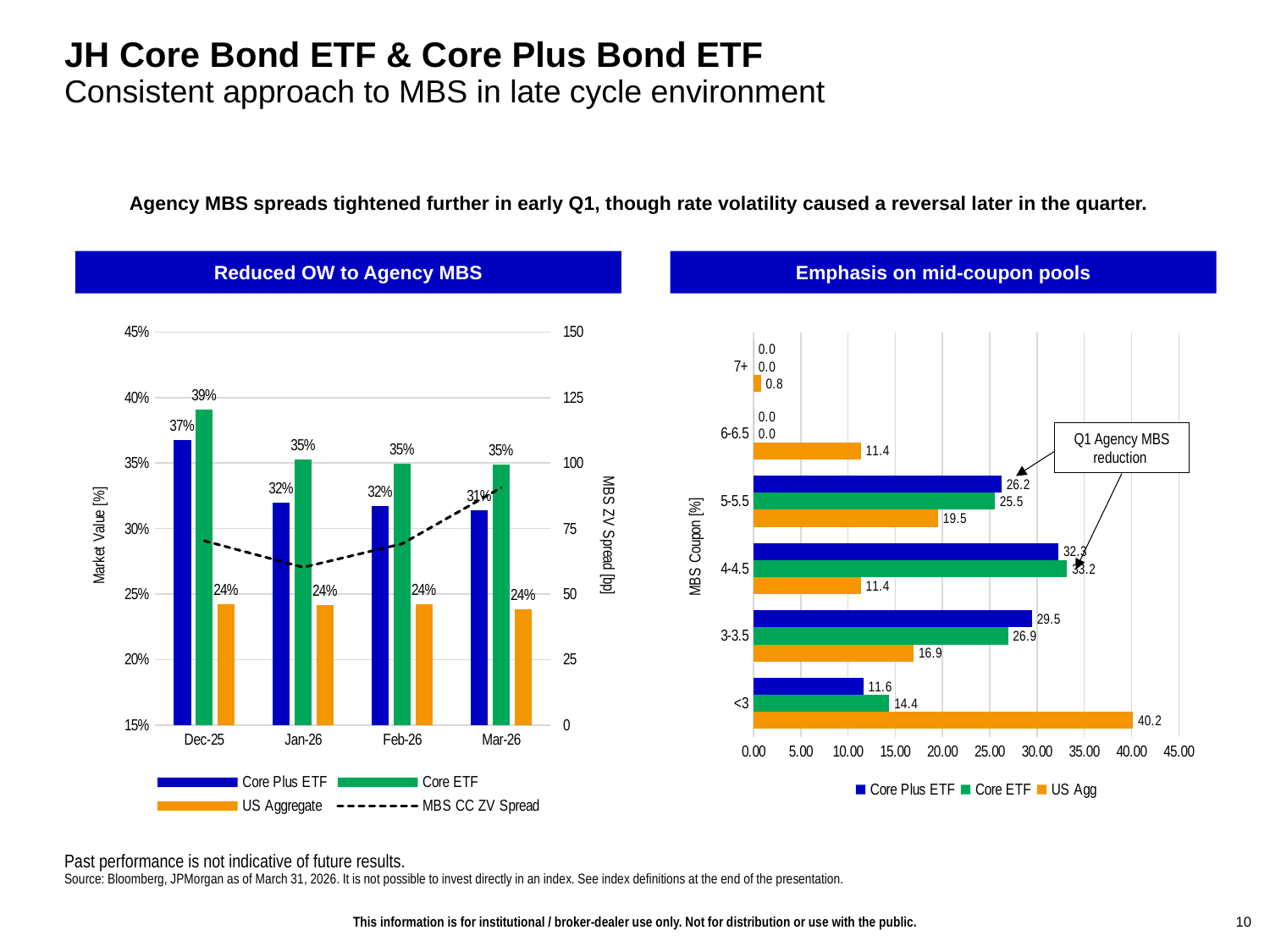
In the 'Emphasis on mid-coupon pools' chart, what is the US Agg value for the <3 coupon bucket? 40.2 In the 'Reduced OW to Agency MBS' chart, how many series does the legend list? 4 In the 'Reduced OW to Agency MBS' chart, what is the Core Plus ETF value for Dec-25? 37% In the 'Reduced OW to Agency MBS' chart, what is the difference between the Core ETF and US Aggregate values for Mar-26? 11% What type of chart is the 'Emphasis on mid-coupon pools' chart? Bar chart In the 'Emphasis on mid-coupon pools' chart, which coupon bucket has the highest Core ETF value? 4-4.5 In the 'Reduced OW to Agency MBS' chart, which month has the highest Core ETF value? Dec-25 In the 'Emphasis on mid-coupon pools' chart, how many coupon buckets are shown on the vertical axis? 6 In the 'Emphasis on mid-coupon pools' chart, which is larger for the 3-3.5 bucket: Core Plus ETF or Core ETF? Core Plus ETF In the 'Reduced OW to Agency MBS' chart, what is the Core ETF value for Jan-26? 35% In the 'Reduced OW to Agency MBS' chart, does the Core Plus ETF value rise or fall from Dec-25 to Mar-26? Fall In the 'Emphasis on mid-coupon pools' chart, what is the Core Plus ETF value for the 4-4.5 coupon bucket? 32.3